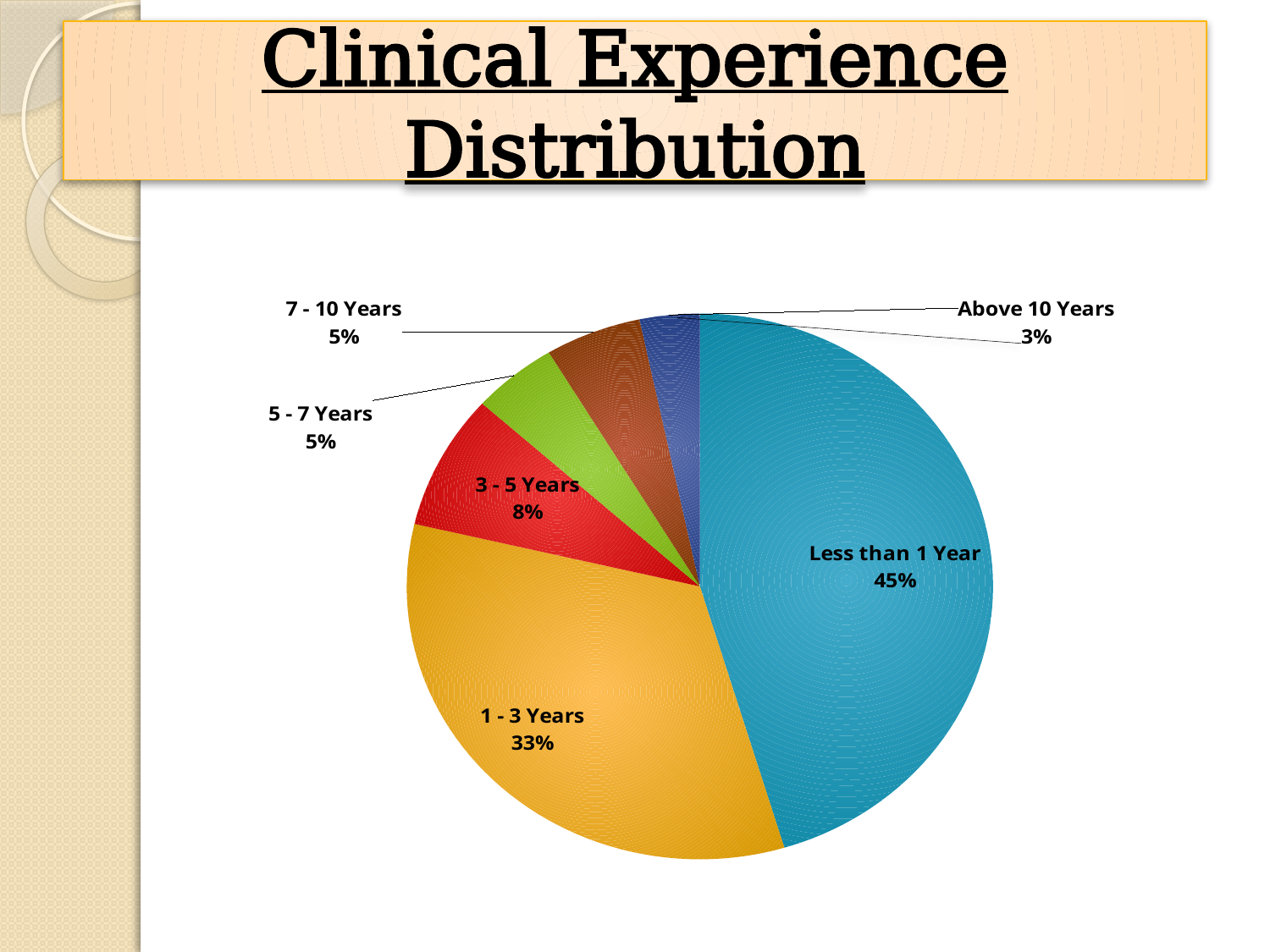
What is the difference in percentage points between the 'Less than 1 Year' and '1 - 3 Years' slices? 12 What kind of chart is shown on the slide? pie chart What percentage is shown for the 'Above 10 Years' slice? 3% What is the title of the slide containing the pie chart? Clinical Experience Distribution Which slice is larger, '3 - 5 Years' or '5 - 7 Years'? 3 - 5 Years What percentage is shown for the '3 - 5 Years' slice? 8% Which category has the smallest slice of the pie? Above 10 Years How many slices does the pie chart have? 6 What is the combined percentage of the '5 - 7 Years' and '7 - 10 Years' slices? 10% What percentage is shown for the '1 - 3 Years' slice? 33% What share of the pie does the 'Less than 1 Year' slice represent? 45% Which category has the largest slice of the pie? Less than 1 Year